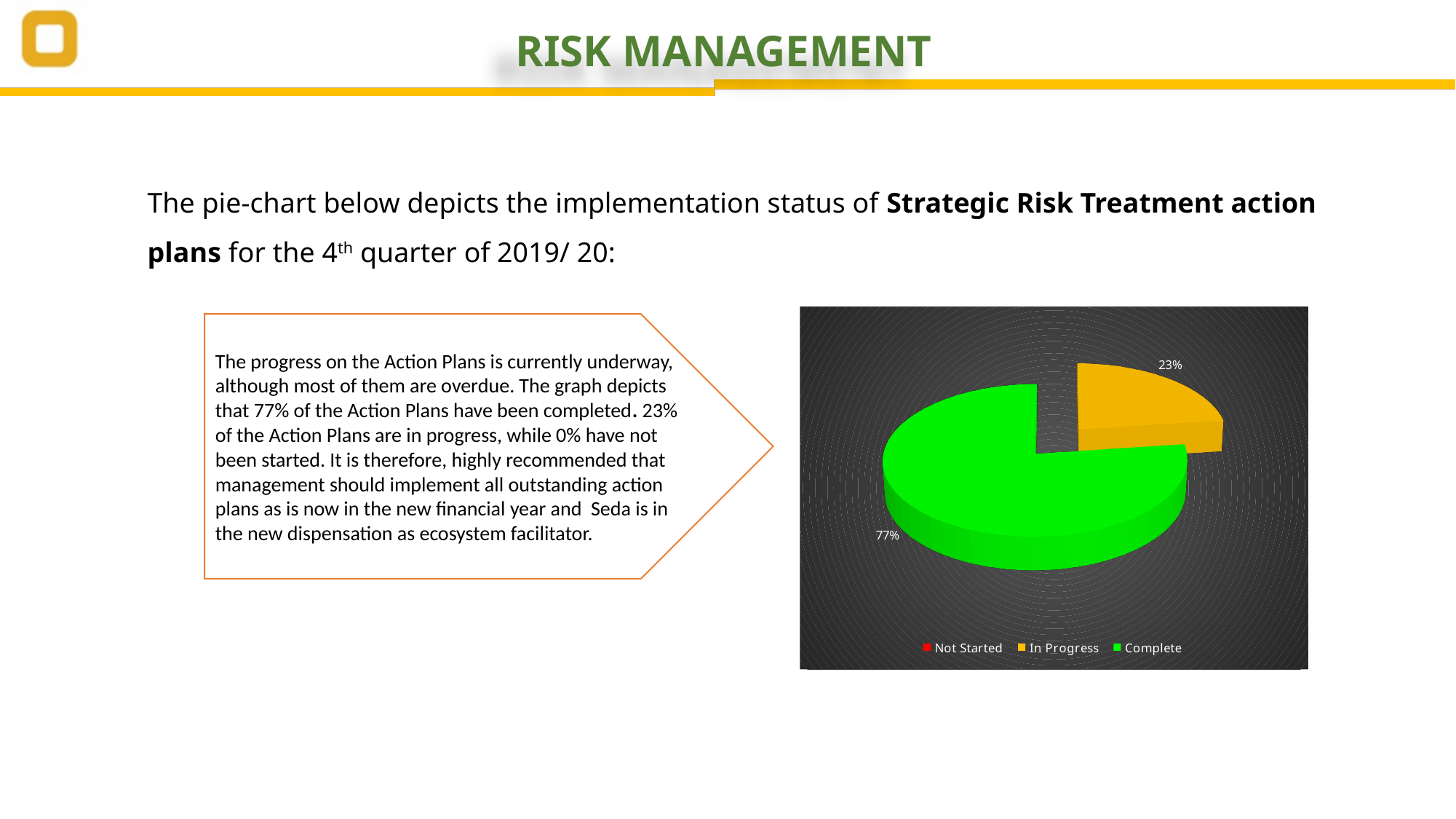
Is the share for Complete greater or less than 50%? greater How many categories does the legend list? 3 Which legend entry is shown in green? Complete What share of the pie does the In Progress slice represent? 23% Which of the two visible slices is larger, In Progress or Complete? Complete What kind of chart is shown on the slide? pie chart What share of the pie does the Complete slice represent? 77% What is the difference in percentage points between the Complete and In Progress slices? 54 Which category has the largest slice of the pie? Complete Which legend entry is shown in red? Not Started